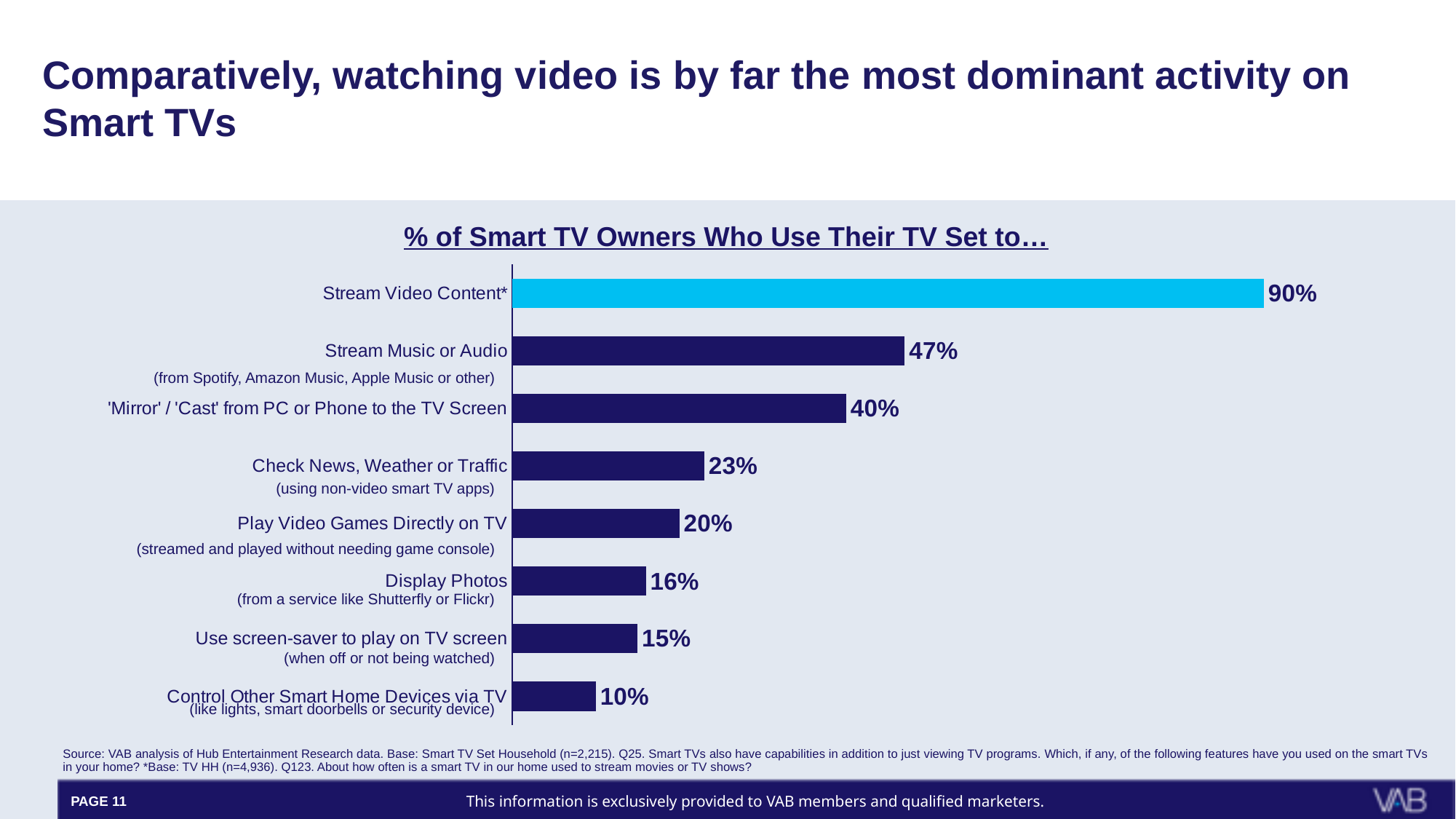
Which activity has the highest percentage of Smart TV owners? Stream Video Content* How many activities (bars) are shown in the chart? 8 What percentage of Smart TV owners use their TV set to Stream Music or Audio? 47% Which activity has the lowest percentage of Smart TV owners? Control Other Smart Home Devices via TV What is the value for 'Mirror' / 'Cast' from PC or Phone to the TV Screen? 40% What percentage of Smart TV owners use their TV set to Display Photos? 16% Which bar is shown in a different (light blue) colour from the others? Stream Video Content* Which is larger: the value for Check News, Weather or Traffic or the value for Play Video Games Directly on TV? Check News, Weather or Traffic What is the title of the chart? % of Smart TV Owners Who Use Their TV Set to… What is the difference between the percentage for Stream Video Content and Stream Music or Audio? 43% What kind of chart is shown on the slide? Bar chart What percentage of Smart TV owners use their TV set to Stream Video Content? 90%